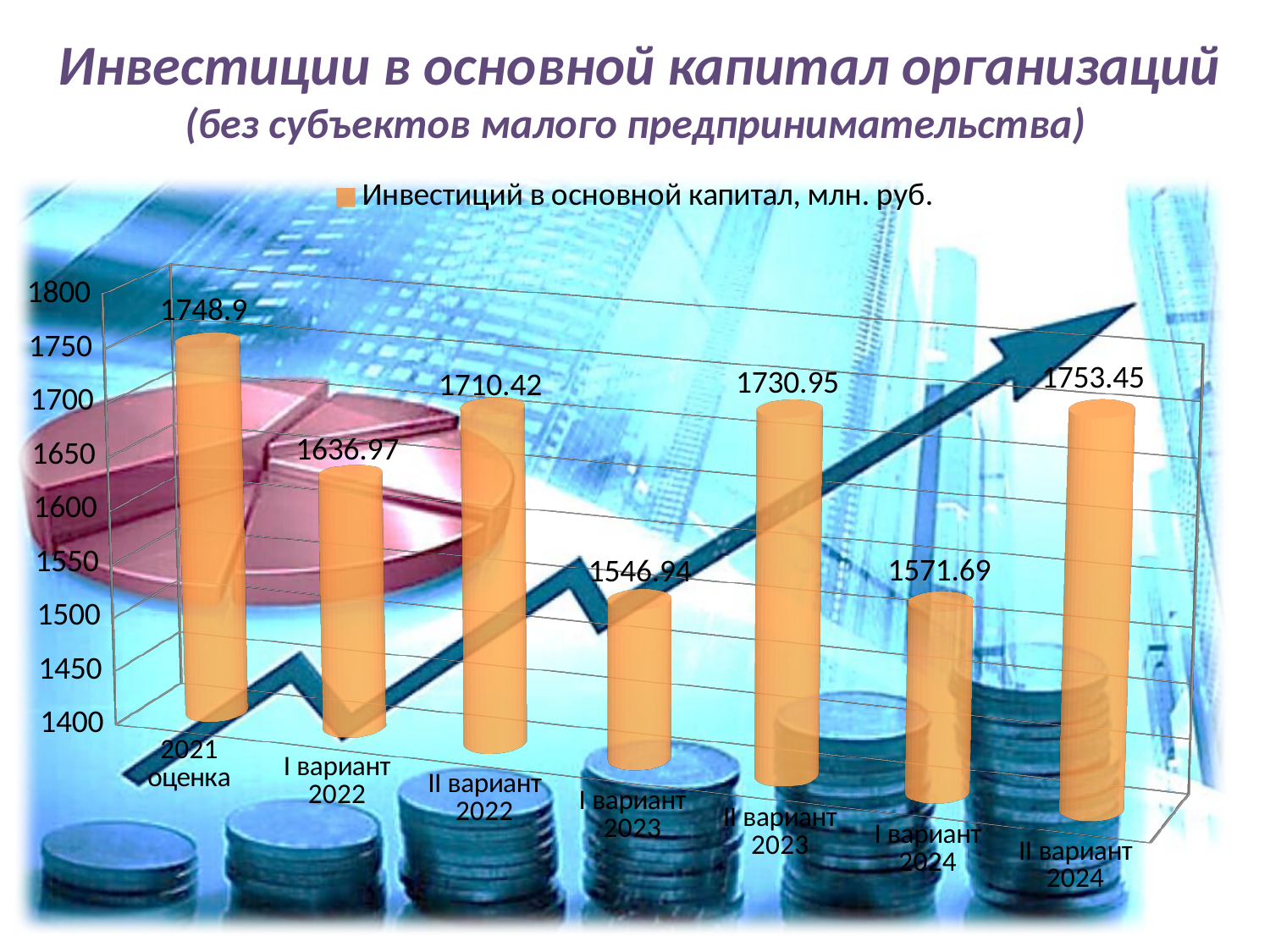
Which category has the highest value? II вариант 2024 What is the value for II вариант 2024? 1753.45 What is the value for 2021 оценка? 1748.9 What is the difference between the values for II вариант 2023 and I вариант 2023? 184.01 What is the value for II вариант 2022? 1710.42 Which category has the lowest value? I вариант 2023 How many categories are shown on the chart? 7 Which is larger, the value for II вариант 2022 or the value for II вариант 2023? II вариант 2023 What is the legend entry of the series shown on the chart? Инвестиций в основной капитал, млн. руб. What kind of chart is shown on the slide? Bar chart What is the value for I вариант 2023? 1546.94 What is the difference between the values for 2021 оценка and I вариант 2022? 111.93